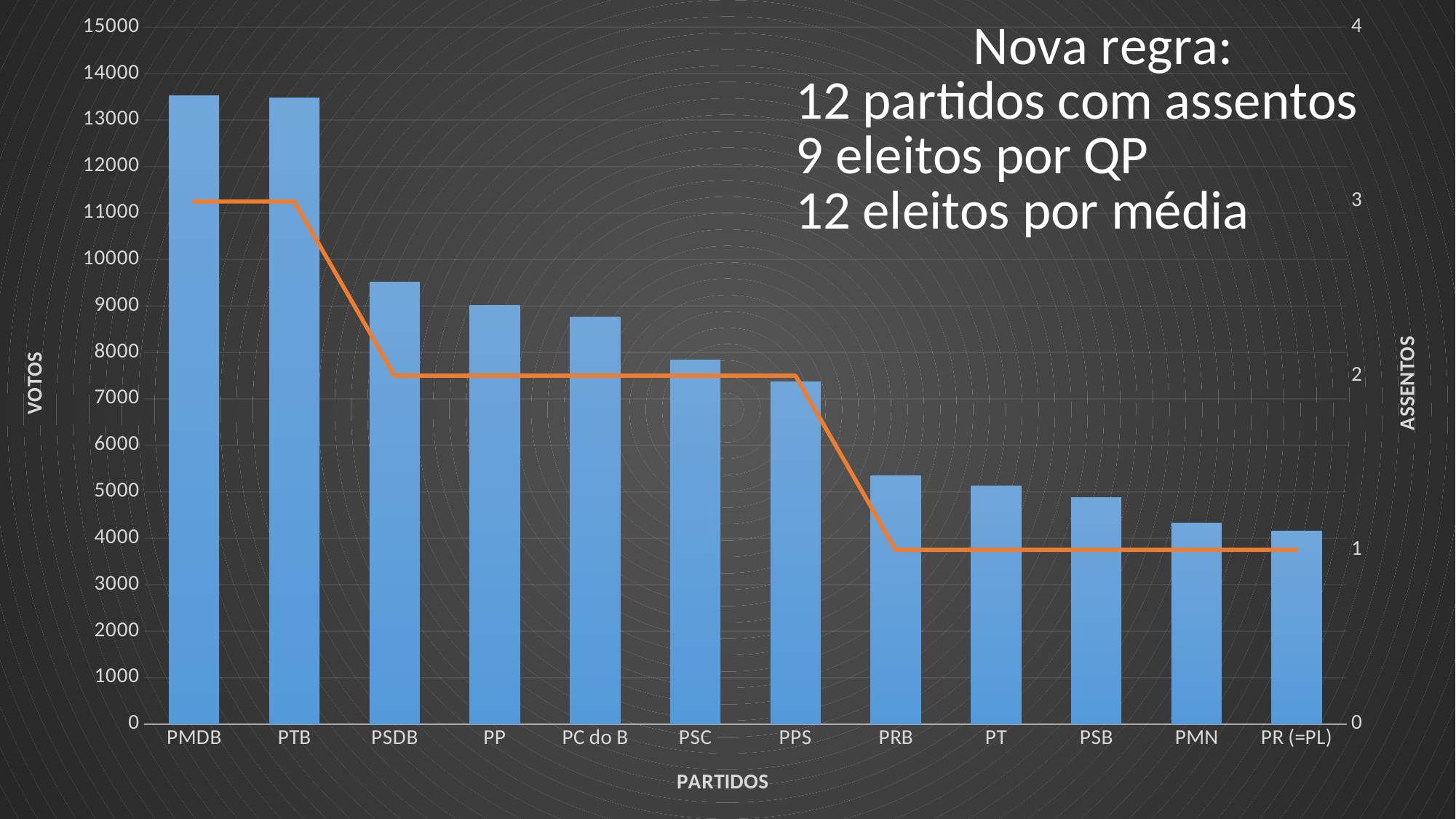
What is the title of the left vertical axis? VOTOS Is the VOTOS value for PPS greater or less than 8000? less According to the line (ASSENTOS axis), how many seats does PRB have? 1 Which party has more votes, PSDB or PRB? PSDB Is the VOTOS value for PMN greater or less than 4000? greater What kind of chart is shown on the slide? Bar chart combined with a line Is the VOTOS value for PSB greater or less than 5000? less According to the line (ASSENTOS axis), how many seats does PSDB have? 2 According to the line (ASSENTOS axis), how many seats does PMDB have? 3 Do the vote bars rise or fall from left to right along the x axis? Fall How many parties (categories) are shown on the x axis of the chart? 12